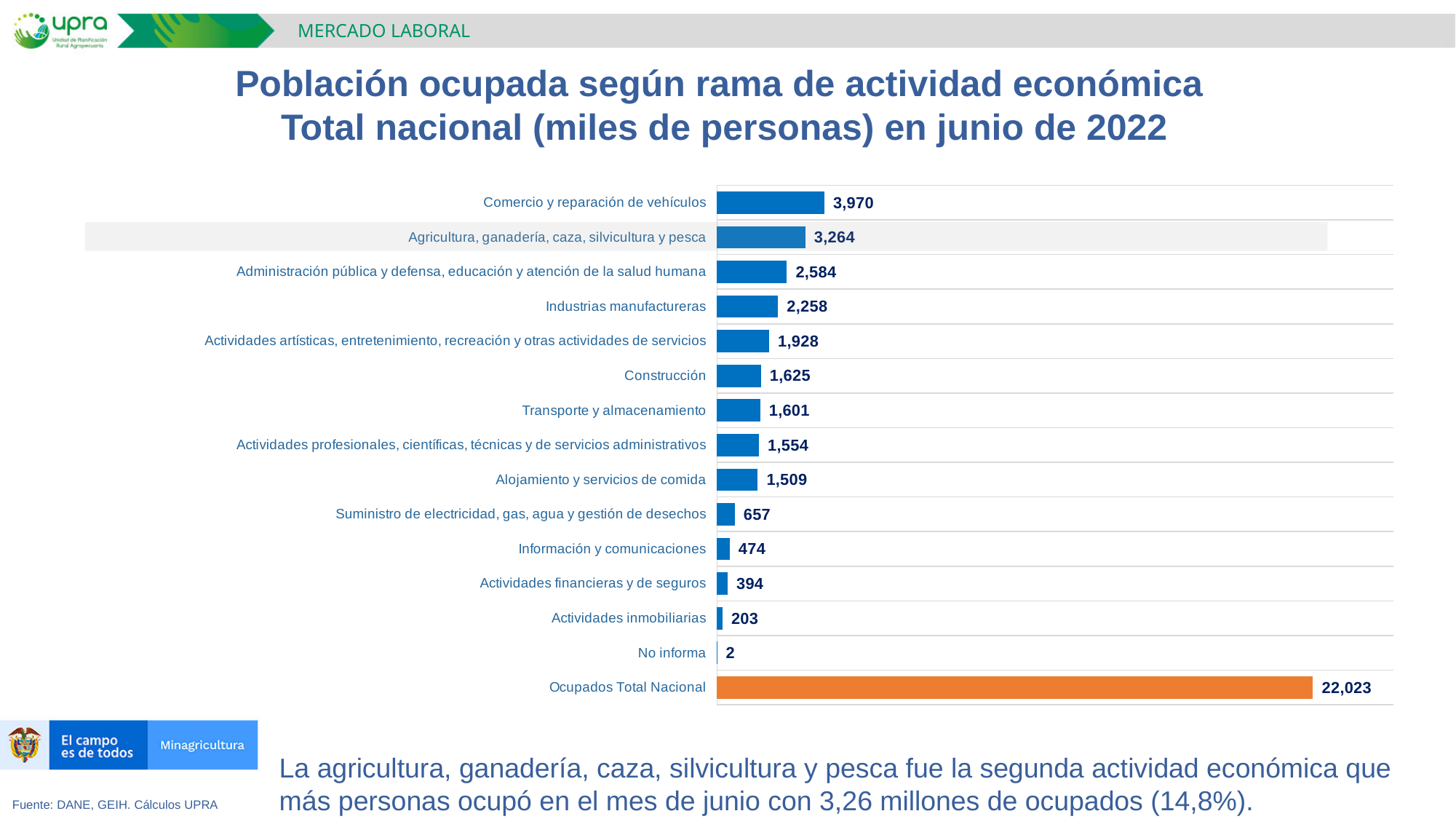
What is the value for Comercio y reparación de vehículos? 3,970 Which category has the lowest value? No informa What is the value for Agricultura, ganadería, caza, silvicultura y pesca? 3,264 What kind of chart is shown on the slide? Bar chart Which bar is shown in orange rather than blue? Ocupados Total Nacional What is the value for Ocupados Total Nacional? 22,023 Which is larger, Información y comunicaciones or Actividades financieras y de seguros? Información y comunicaciones How many bars are shown in the chart? 15 Excluding the Ocupados Total Nacional bar, which economic activity has the highest value? Comercio y reparación de vehículos What is the value for Construcción? 1,625 What is the difference between Administración pública y defensa, educación y atención de la salud humana and Industrias manufactureras? 326 What is the difference between Comercio y reparación de vehículos and Agricultura, ganadería, caza, silvicultura y pesca? 706